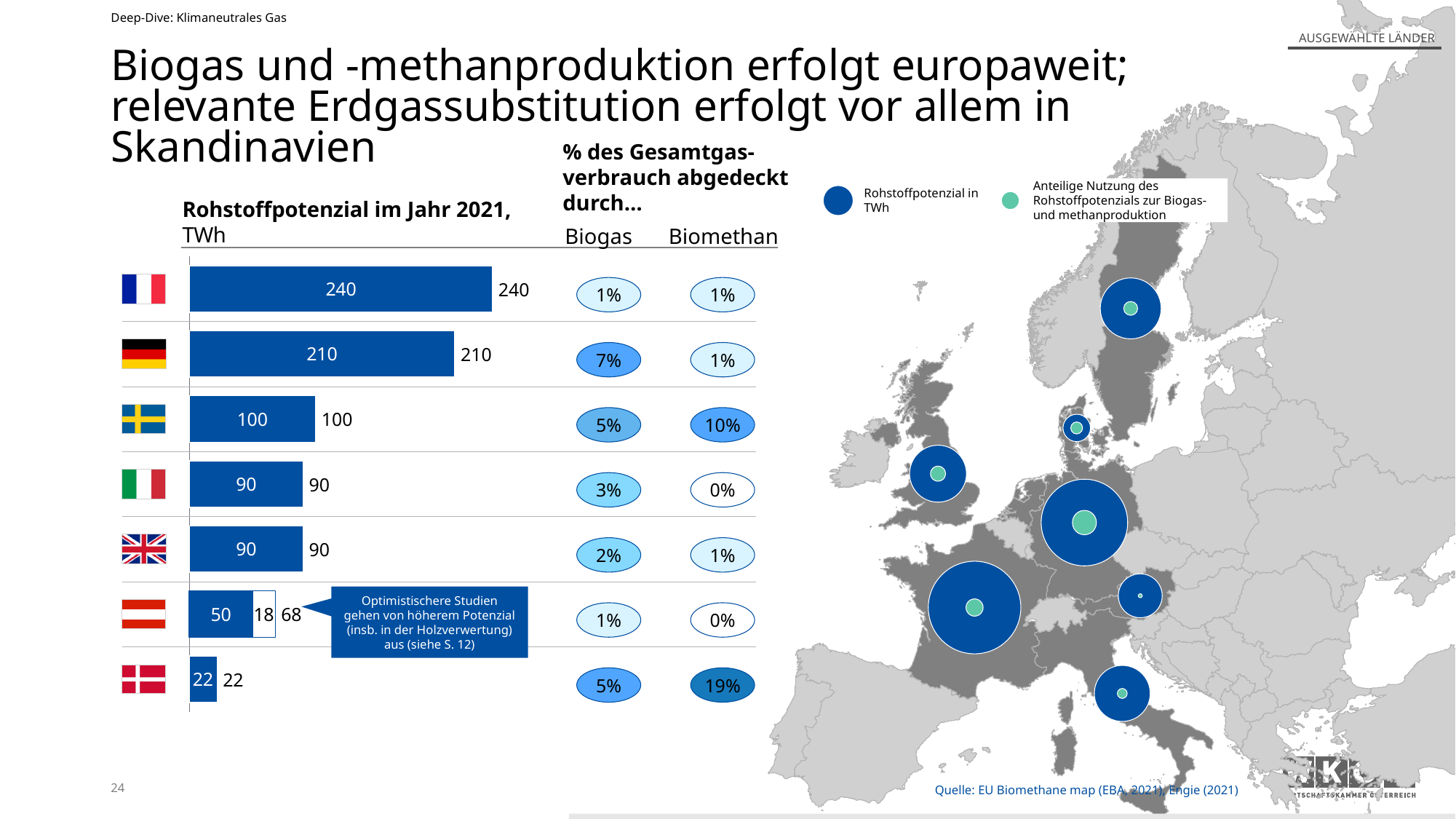
In the Rohstoffpotenzial im Jahr 2021 bar chart, what is the value for the row with the German flag? 210 In the Rohstoffpotenzial im Jahr 2021 bar chart, what is the value for the row with the Swedish flag? 100 In the Rohstoffpotenzial im Jahr 2021 bar chart, which is larger: the value for Germany or the value for Sweden? Germany In the Rohstoffpotenzial im Jahr 2021 bar chart, what is the difference between the values for France and Germany? 30 In the Biogas column of the table next to the bar chart, what percentage is shown for the row with the German flag? 7% What kind of chart is used to show the Rohstoffpotenzial im Jahr 2021 values on the left of the slide? bar chart In the Rohstoffpotenzial im Jahr 2021 bar chart, which country (by flag) has the highest value? France How many series does the legend of the map chart on the right list? 2 In the Rohstoffpotenzial im Jahr 2021 bar chart, what is the total of the stacked bar for the row with the Austrian flag? 68 In the Biomethan column of the table next to the bar chart, what percentage is shown for the row with the Danish flag? 19% In the Rohstoffpotenzial im Jahr 2021 bar chart, which country (by flag) has the lowest value? Denmark How many countries (flag rows) are shown in the Rohstoffpotenzial im Jahr 2021 bar chart? 7